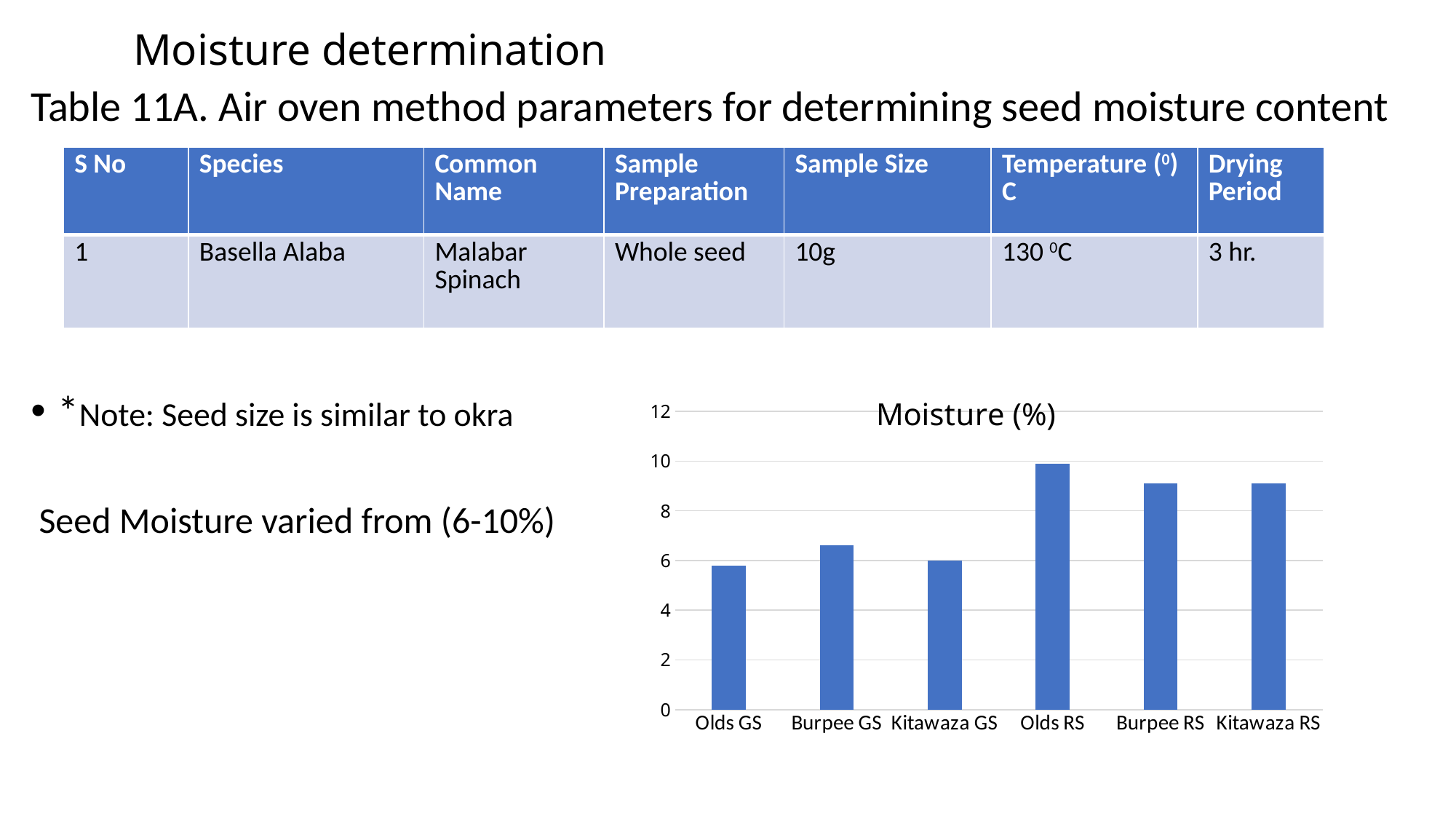
Is the value for Kitawaza RS greater or less than 8? greater Which category has the highest moisture value in the chart? Olds RS Is the value for Burpee RS greater or less than 10? less Is the value for Burpee GS greater or less than 6? greater Which is larger, the value for Burpee GS or the value for Olds GS? Burpee GS What is the highest value shown on the chart's y axis? 12 What is the title of the chart? Moisture (%) Which is larger, the value for Olds RS or the value for Burpee RS? Olds RS How many categories are plotted on the x axis of the chart? 6 What type of chart is shown on the slide? bar chart